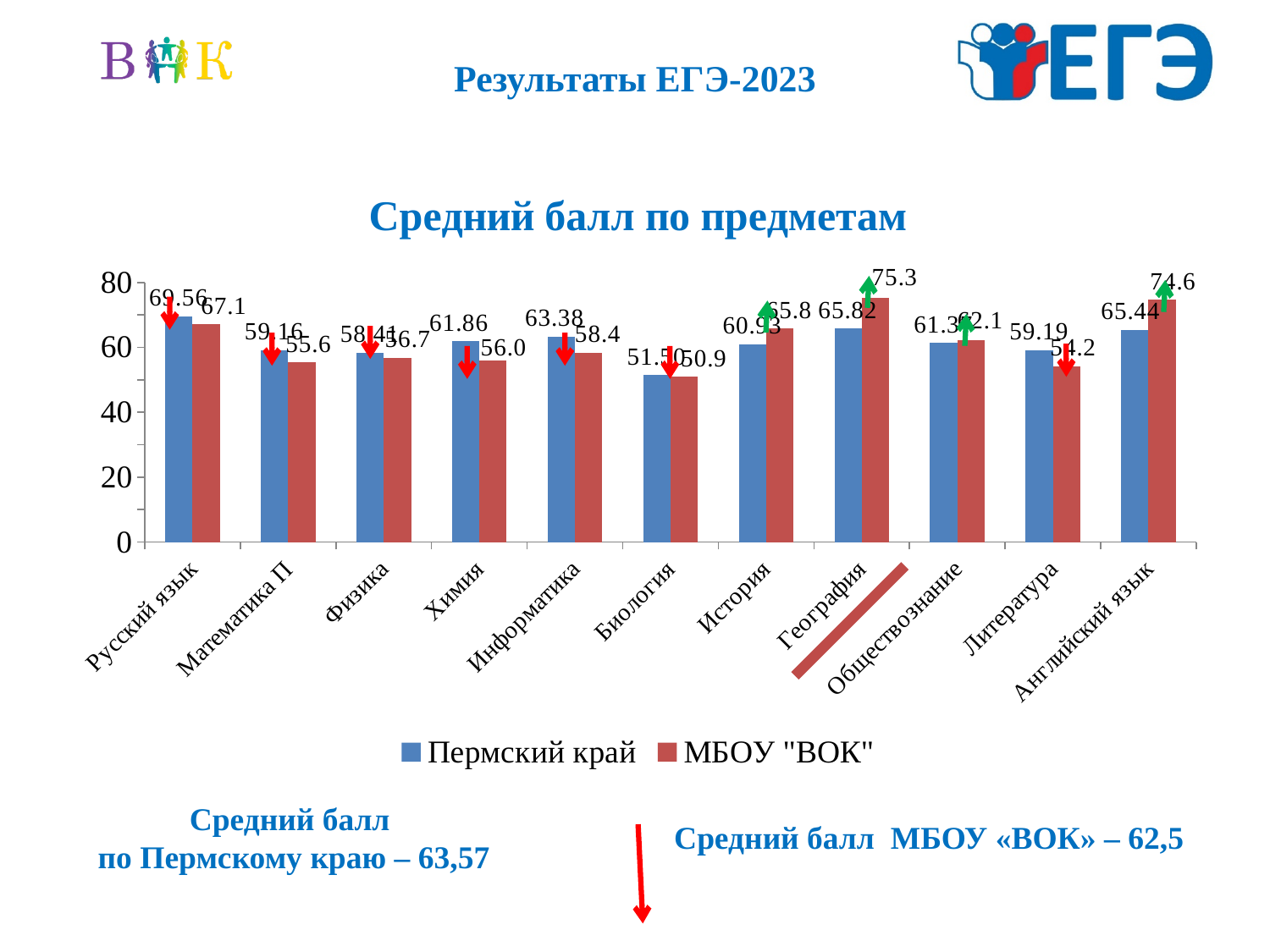
What kind of chart is shown on the slide? Bar chart How many subjects (categories) are shown on the x axis of the chart? 11 What is the value for Пермский край in Английский язык? 65.44 How many series does the legend of the chart list? 2 In Английский язык, which series has the larger value: Пермский край or МБОУ "ВОК"? МБОУ "ВОК" What is the value for МБОУ "ВОК" in География? 75.3 Which subject has the highest value for МБОУ "ВОК"? География Which subject has the lowest value for Пермский край? Биология What is the value for Пермский край in Русский язык? 69.56 What is the difference between the Пермский край and МБОУ "ВОК" values in Химия? 5.86 What is the title of the chart? Средний балл по предметам Is the value for МБОУ "ВОК" in Литература greater or less than 60? less